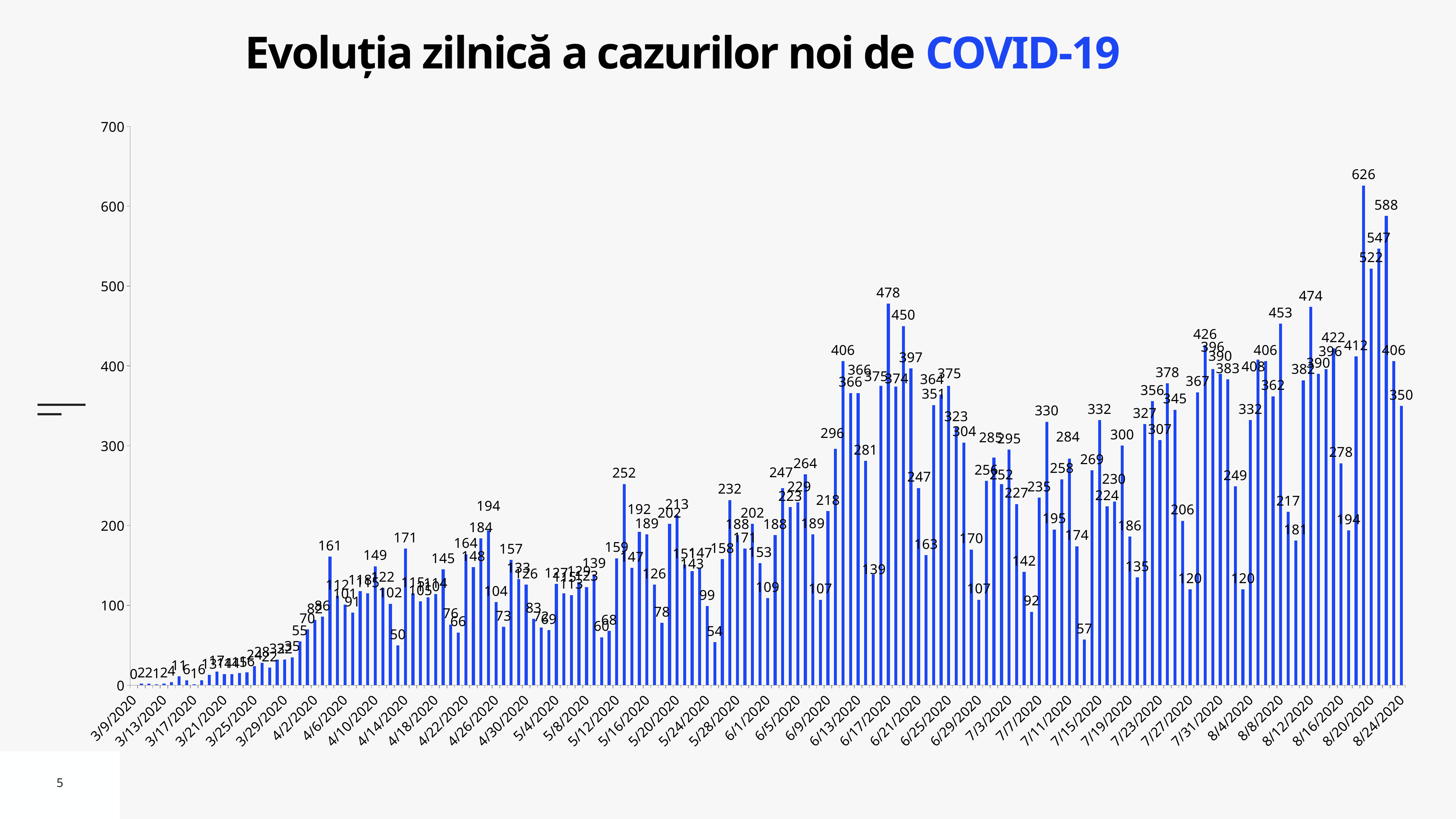
What is the highest value shown on the y axis? 700 What kind of chart is shown on the slide? bar chart Overall, do the daily values rise or fall from March to August along the x axis? rise What is the difference between the two highest labelled values, 626 and 588? 38 Which is larger, the peak labelled 626 or the peak labelled 588? 626 Is the value for 8/24/2020 greater or less than 300? greater What is the title of the chart? Evoluția zilnică a cazurilor noi de COVID-19 What is the value for the last date on the x axis, 8/24/2020? 350 What is the lowest daily value labelled in the chart? 0 What is the difference between the labelled values 478 and 450 in the June peak? 28 What is the highest daily value shown in the chart? 626 What is the value for the first date on the x axis, 3/9/2020? 0